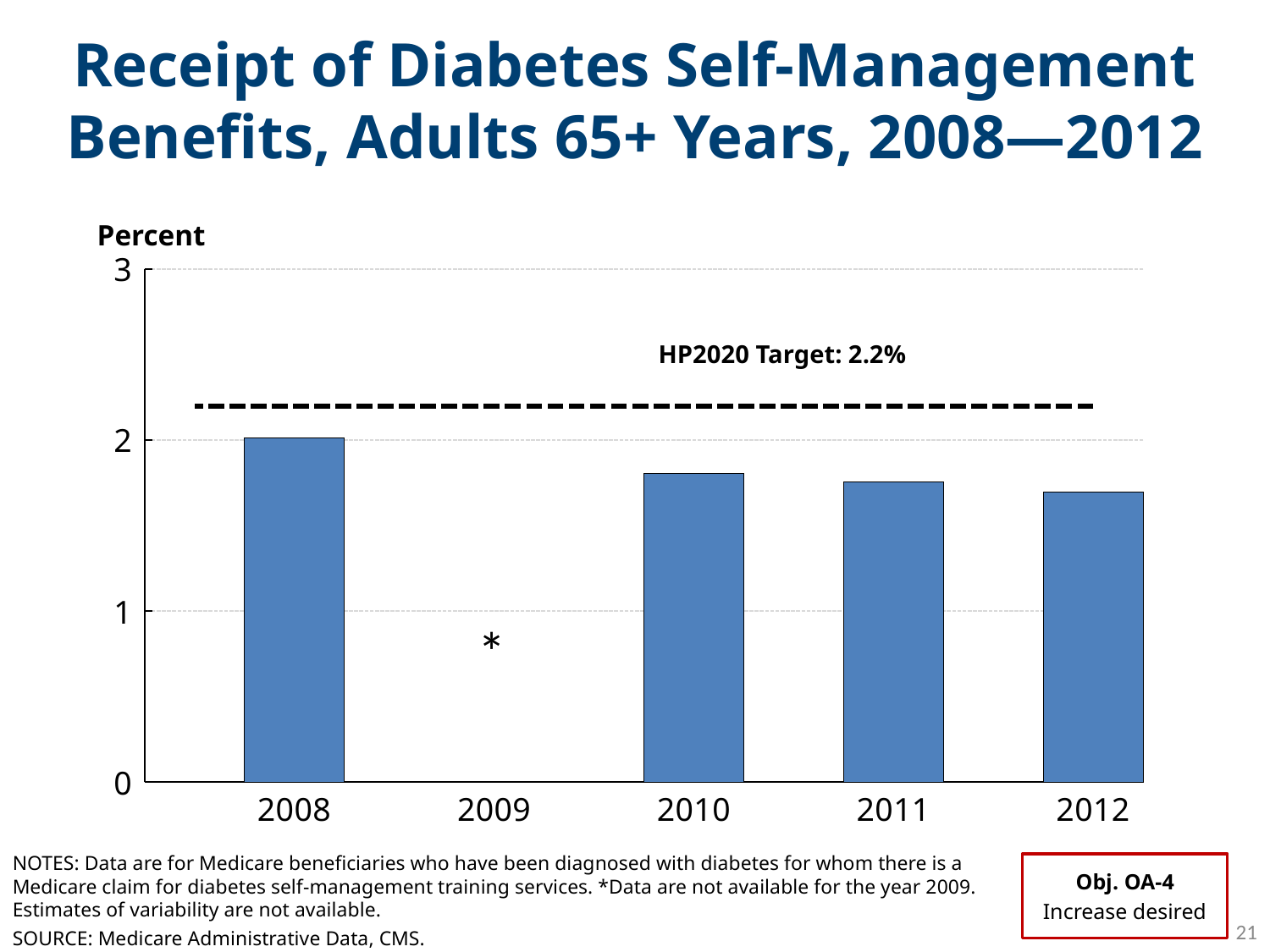
What is the HP2020 target shown on the chart? 2.2% Which is larger, the value for 2008 or the value for 2010? 2008 Which is larger, the value for 2010 or the value for 2012? 2010 Is the value for 2010 greater or less than 1? greater Is the value for 2012 greater or less than 2? less What kind of chart is shown on the slide? bar chart How many years are labeled on the x axis? 5 Do the values rise or fall from 2010 to 2012? fall Is the value for 2011 greater or less than 2? less Which year has the highest value in the chart? 2008 For which year are data not available in the chart? 2009 How many bars are plotted in the chart? 4